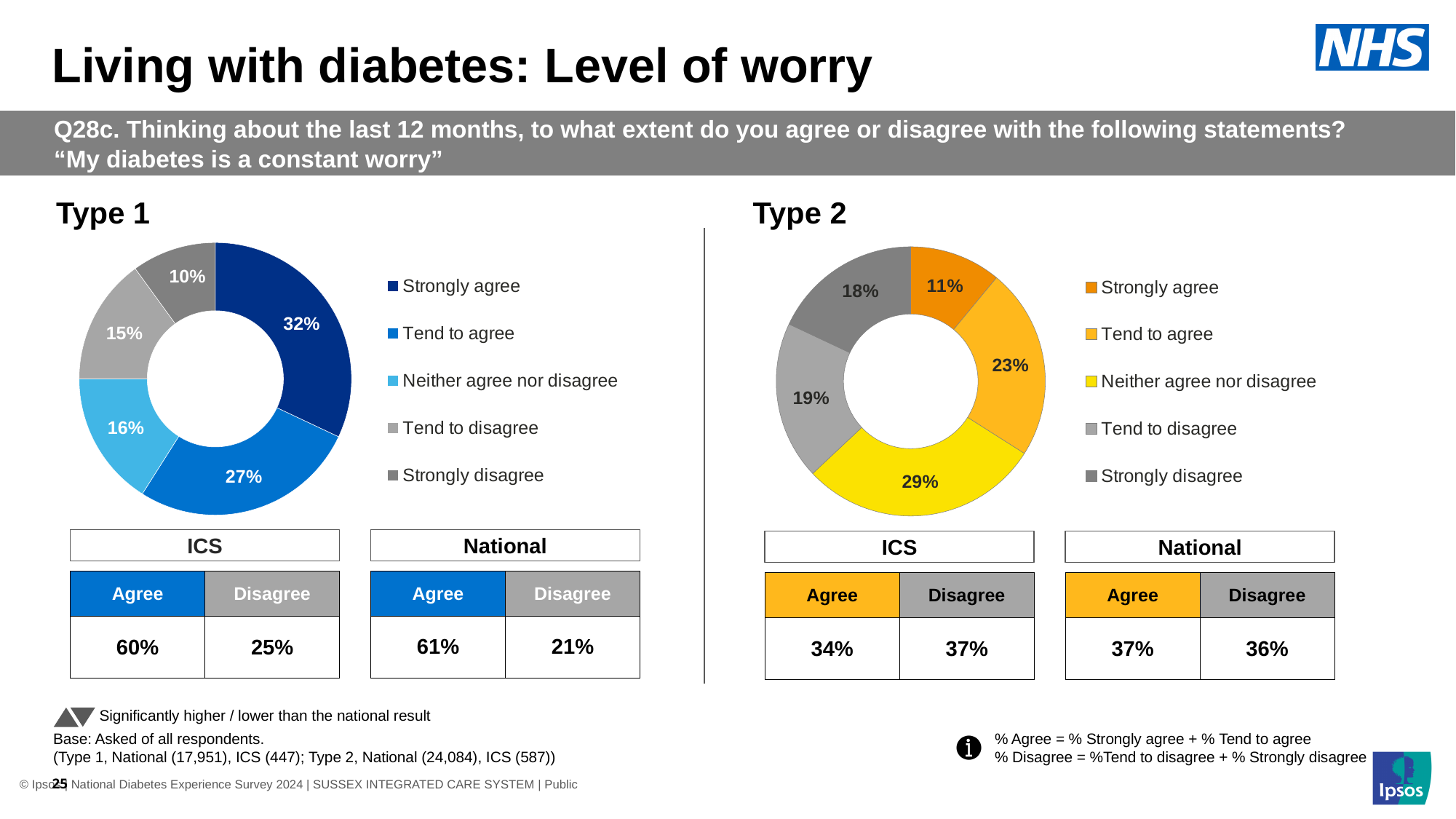
How many segments does the Type 1 chart have? 5 How many entries does the legend of the Type 2 chart list? 5 In the Type 2 chart, what percentage of respondents strongly disagree? 18% In the Type 2 chart, what percentage of respondents neither agree nor disagree? 29% In the Type 1 chart, what is the combined share of Strongly agree and Tend to agree? 59% In the Type 1 chart, which response category has the largest share? Strongly agree What colour is the Neither agree nor disagree segment in the Type 2 chart? Yellow In the Type 1 chart, what percentage of respondents strongly agree? 32% What kind of chart is used for Type 1? Doughnut chart In the Type 2 chart, which is larger: Tend to disagree or Strongly disagree? Tend to disagree In the Type 1 chart, what is the difference between the Tend to agree and Tend to disagree shares? 12 percentage points In the Type 2 chart, which response category has the smallest share? Strongly agree